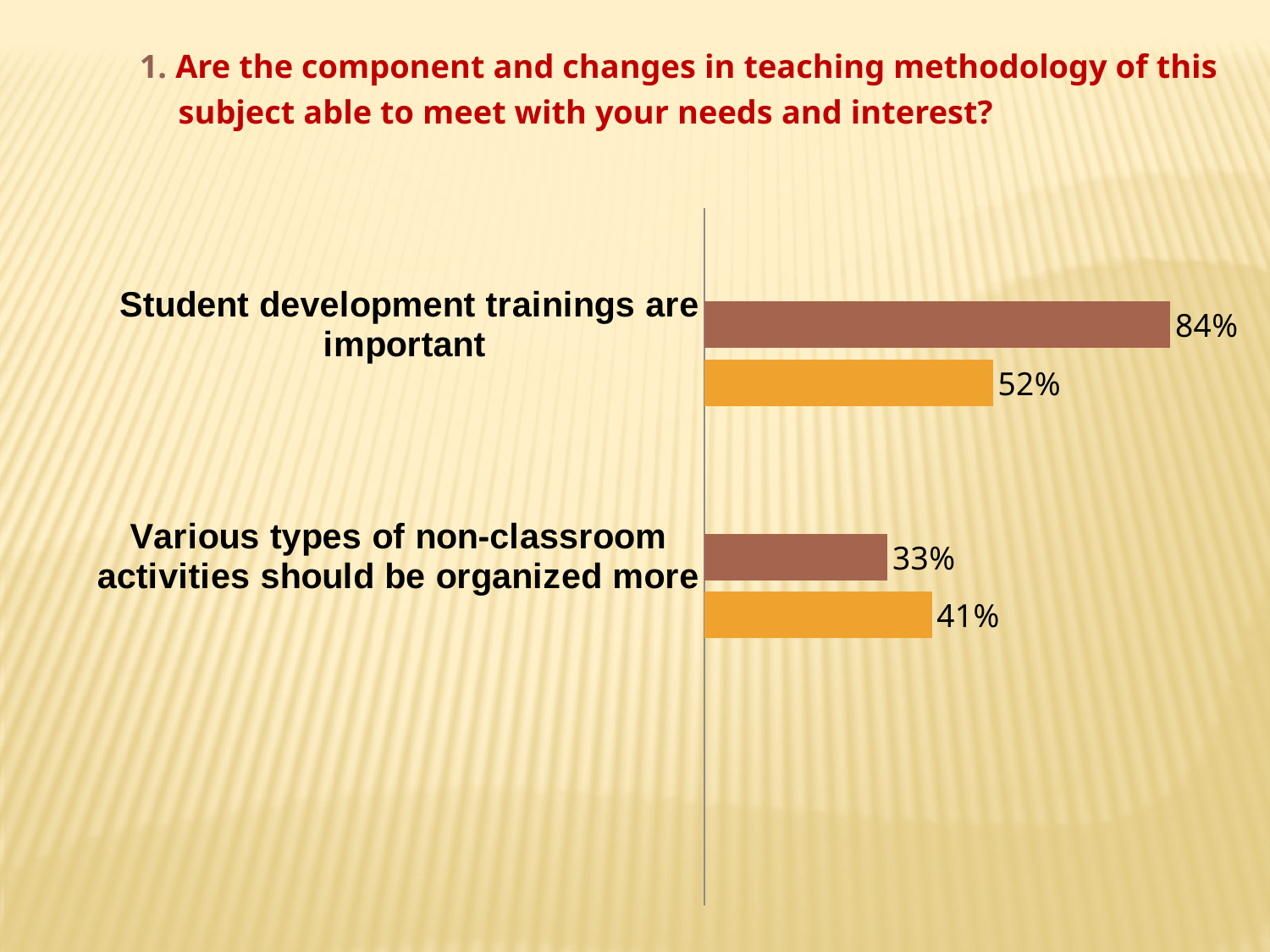
How many categories are shown on the chart? 2 What is the value of the brown bar for "Student development trainings are important"? 84% What is the value of the brown bar for "Various types of non-classroom activities should be organized more"? 33% What is the value of the orange bar for "Student development trainings are important"? 52% What is the value of the orange bar for "Various types of non-classroom activities should be organized more"? 41% Which bar has the lowest value on the chart? The brown bar for "Various types of non-classroom activities should be organized more" (33%) What is the difference between the orange and brown bars for "Various types of non-classroom activities should be organized more"? 8% What is the difference between the brown and orange bars for "Student development trainings are important"? 32% For "Various types of non-classroom activities should be organized more", which bar is larger, the brown or the orange one? The orange bar What type of chart is shown on the slide? Bar chart Which category has the larger brown bar? Student development trainings are important Which bar has the highest value on the chart? The brown bar for "Student development trainings are important" (84%)